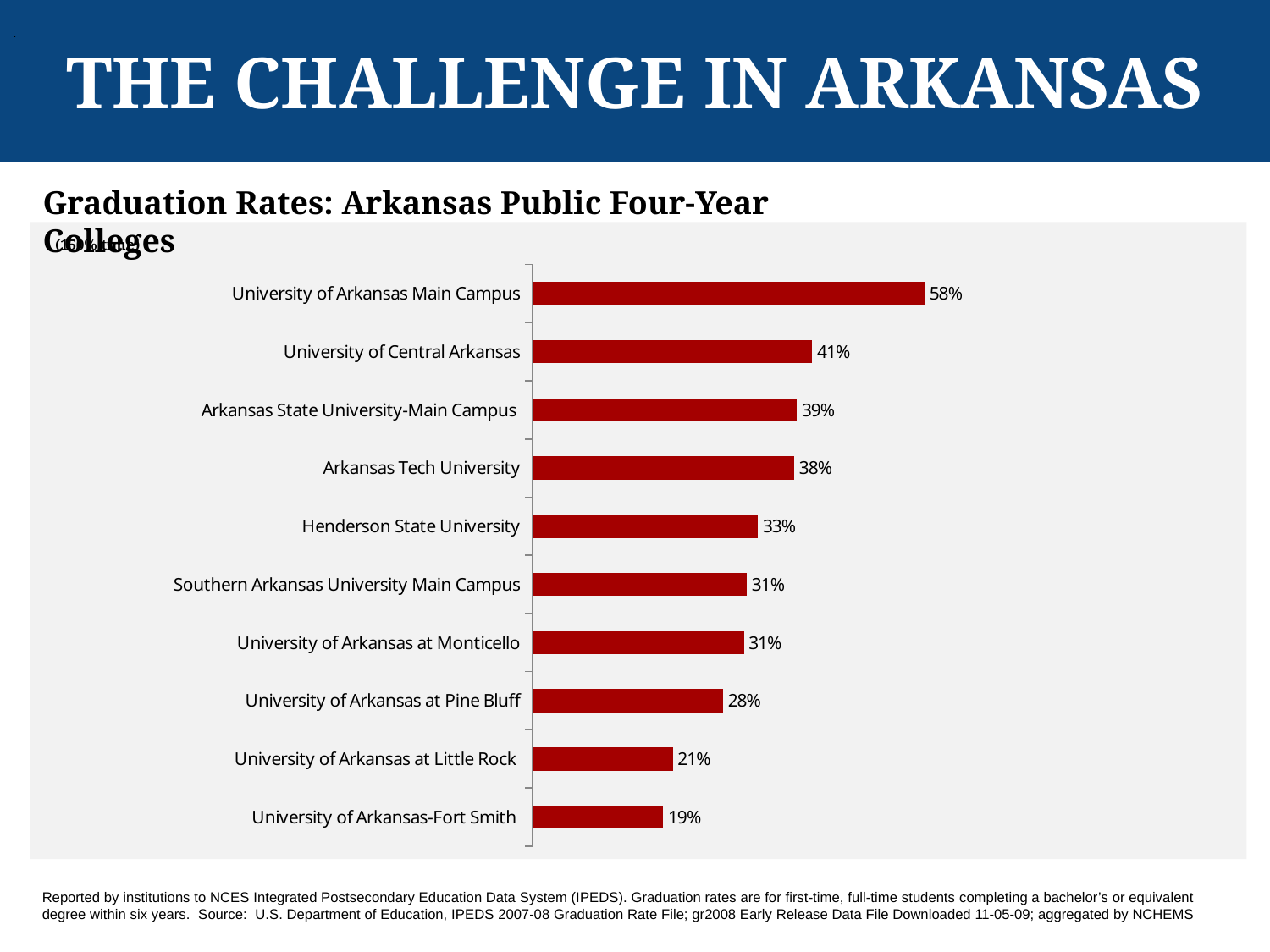
What is the difference in graduation rate between the University of Arkansas Main Campus and the University of Central Arkansas? 17% Which has a higher graduation rate, Arkansas Tech University or Henderson State University? Arkansas Tech University Which institution has the lowest graduation rate? University of Arkansas-Fort Smith What is the graduation rate for Henderson State University? 33% What is the title of the chart? Graduation Rates: Arkansas Public Four-Year Colleges How many institutions are shown in the chart? 10 What is the graduation rate for the University of Arkansas at Pine Bluff? 28% What is the graduation rate for the University of Arkansas Main Campus? 58% What kind of chart is shown on the slide? Bar chart Which has a higher graduation rate, the University of Arkansas at Pine Bluff or the University of Arkansas at Little Rock? University of Arkansas at Pine Bluff What is the difference in graduation rate between the University of Arkansas at Little Rock and the University of Arkansas-Fort Smith? 2% Which institution has the highest graduation rate? University of Arkansas Main Campus